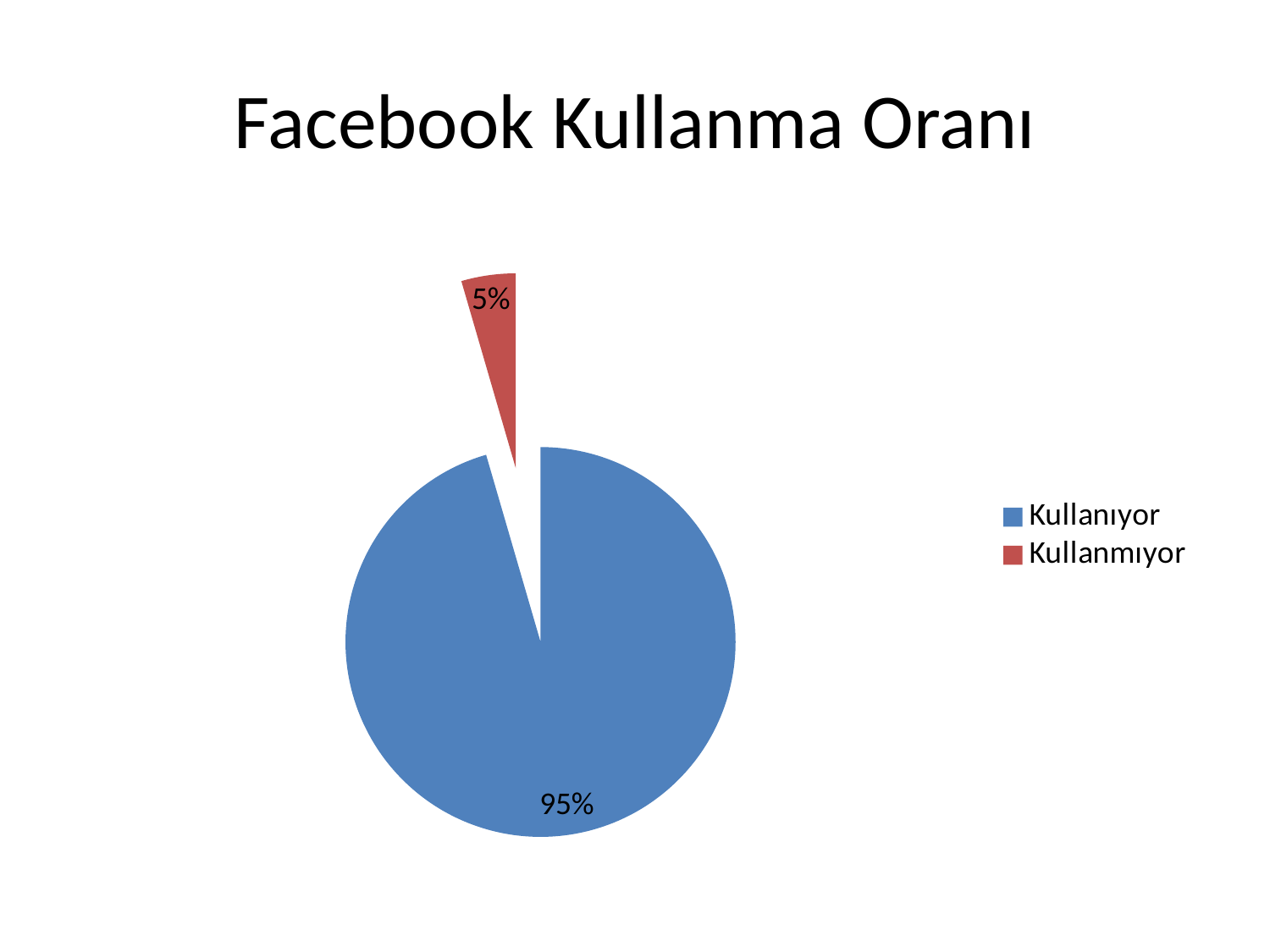
What colour is the slice for Kullanmıyor? Red Which category has the smallest slice of the pie? Kullanmıyor How many entries does the legend list? 2 What share of the pie does Kullanmıyor represent? 5% How many categories does the pie chart show? 2 What is the difference in percentage points between Kullanıyor and Kullanmıyor? 90 What is the title of the slide? Facebook Kullanma Oranı What share of the pie does Kullanıyor represent? 95% Which category has the largest slice of the pie? Kullanıyor Which is larger, the slice for Kullanıyor or the slice for Kullanmıyor? Kullanıyor What kind of chart is shown on the slide? Pie chart